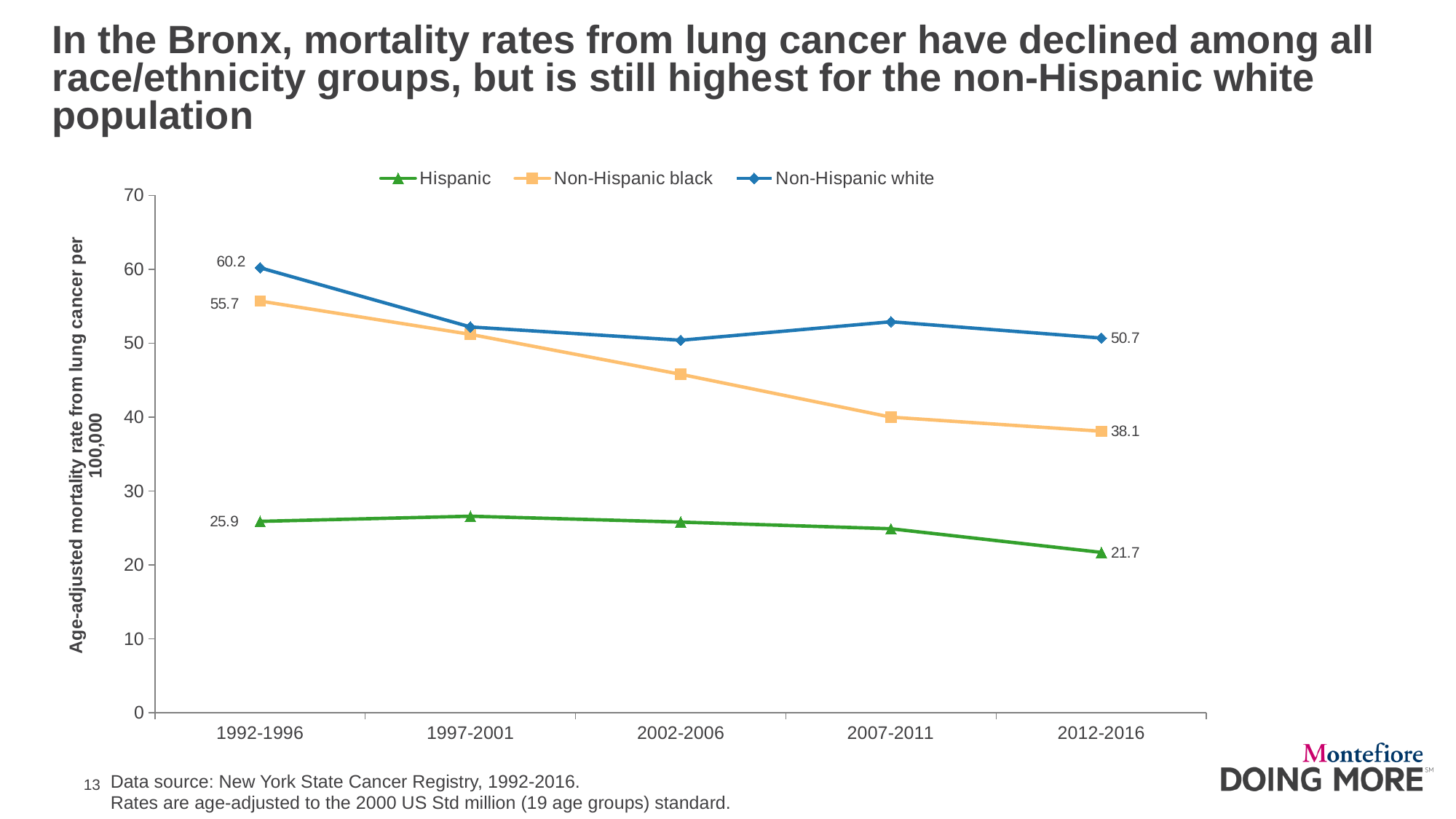
What was the age-adjusted lung cancer mortality rate for the non-Hispanic white population in 1992-1996? 60.2 Which race/ethnicity group had the lowest lung cancer mortality rate in 1992-1996? Hispanic What was the age-adjusted lung cancer mortality rate for the non-Hispanic black population in 1992-1996? 55.7 Which race/ethnicity group had the highest lung cancer mortality rate in 2012-2016? Non-Hispanic white What was the age-adjusted lung cancer mortality rate for the Hispanic population in 2012-2016? 21.7 By how much did the non-Hispanic black mortality rate decline from 1992-1996 to 2012-2016? 17.6 What kind of chart is shown on the slide? Line chart Is the non-Hispanic black mortality rate in 2002-2006 greater or less than 40? greater How many series does the legend list? 3 By how much did the non-Hispanic white mortality rate decline from 1992-1996 to 2012-2016? 9.5 What was the age-adjusted lung cancer mortality rate for the non-Hispanic black population in 2012-2016? 38.1 How many time periods are shown on the x axis? 5